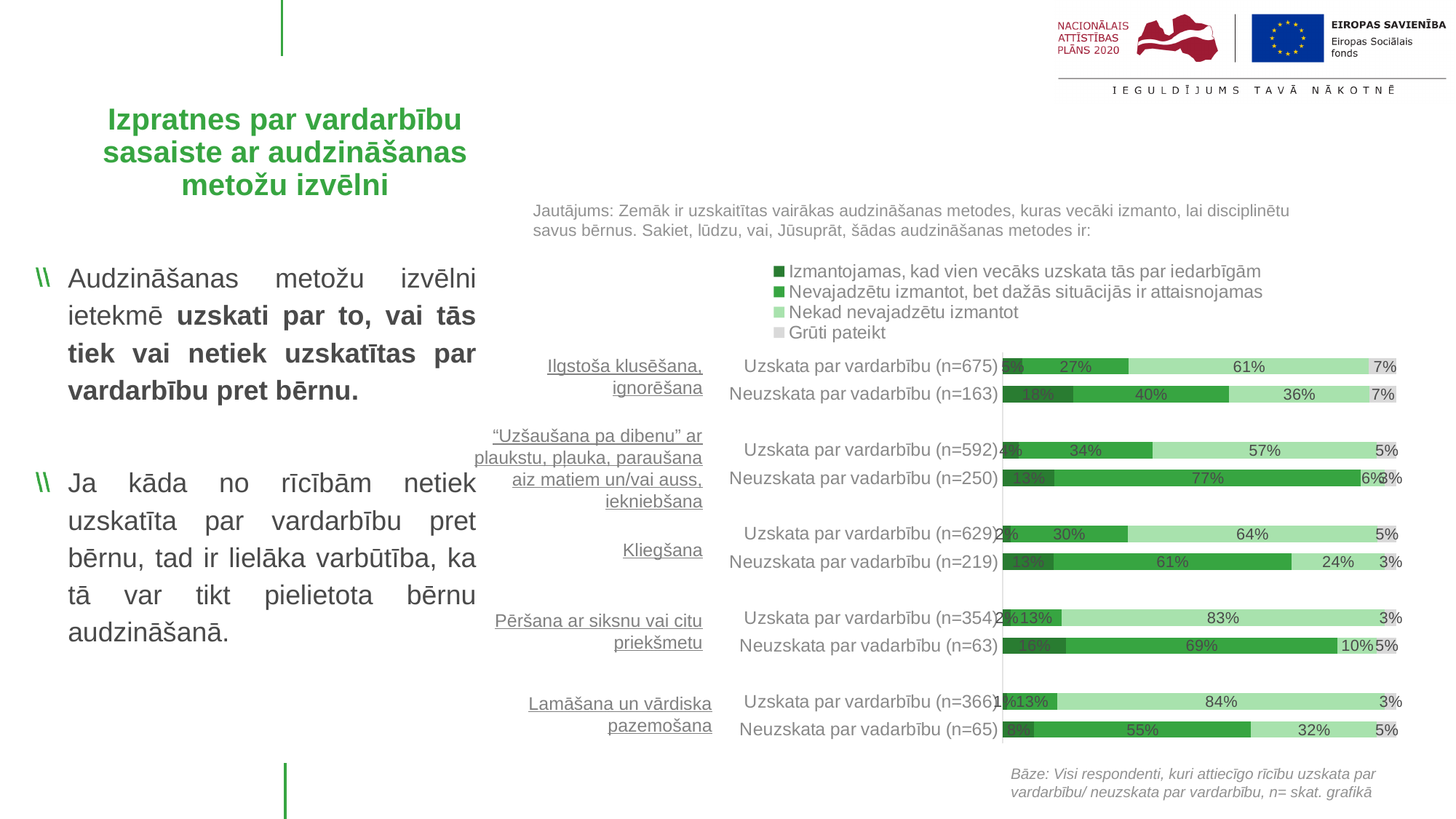
How many bars are plotted in the chart? 10 How many series does the chart legend list? 4 What is the 'Nekad nevajadzētu izmantot' value for 'Uzskata par vardarbību (n=366)' under 'Lamāšana un vārdiska pazemošana'? 84% Which bar has the highest 'Nekad nevajadzētu izmantot' value? Uzskata par vardarbību (n=366), Lamāšana un vārdiska pazemošana What is the 'Nekad nevajadzētu izmantot' value for 'Uzskata par vardarbību (n=675)' under 'Ilgstoša klusēšana, ignorēšana'? 61% What is the difference between the 'Nekad nevajadzētu izmantot' values for 'Uzskata par vardarbību (n=629)' and 'Neuzskata par vardarbību (n=219)' under 'Kliegšana'? 40 percentage points What is the 'Nevajadzētu izmantot, bet dažās situācijās ir attaisnojamas' value for 'Neuzskata par vardarbību (n=250)' under '“Uzšaušana pa dibenu”'? 77% What kind of chart is shown on the slide? Stacked bar chart Which legend entry is shown in the lightest green colour? Nekad nevajadzētu izmantot What is the 'Izmantojamas, kad vien vecāks uzskata tās par iedarbīgām' value for 'Neuzskata par vardarbību (n=163)' under 'Ilgstoša klusēšana, ignorēšana'? 18% Which is larger: the 'Nevajadzētu izmantot, bet dažās situācijās ir attaisnojamas' value for 'Neuzskata par vardarbību (n=63)' or for 'Uzskata par vardarbību (n=354)' under 'Pēršana ar siksnu vai citu priekšmetu'? Neuzskata par vardarbību (n=63) What is the 'Grūti pateikt' value for 'Neuzskata par vardarbību (n=65)' under 'Lamāšana un vārdiska pazemošana'? 5%